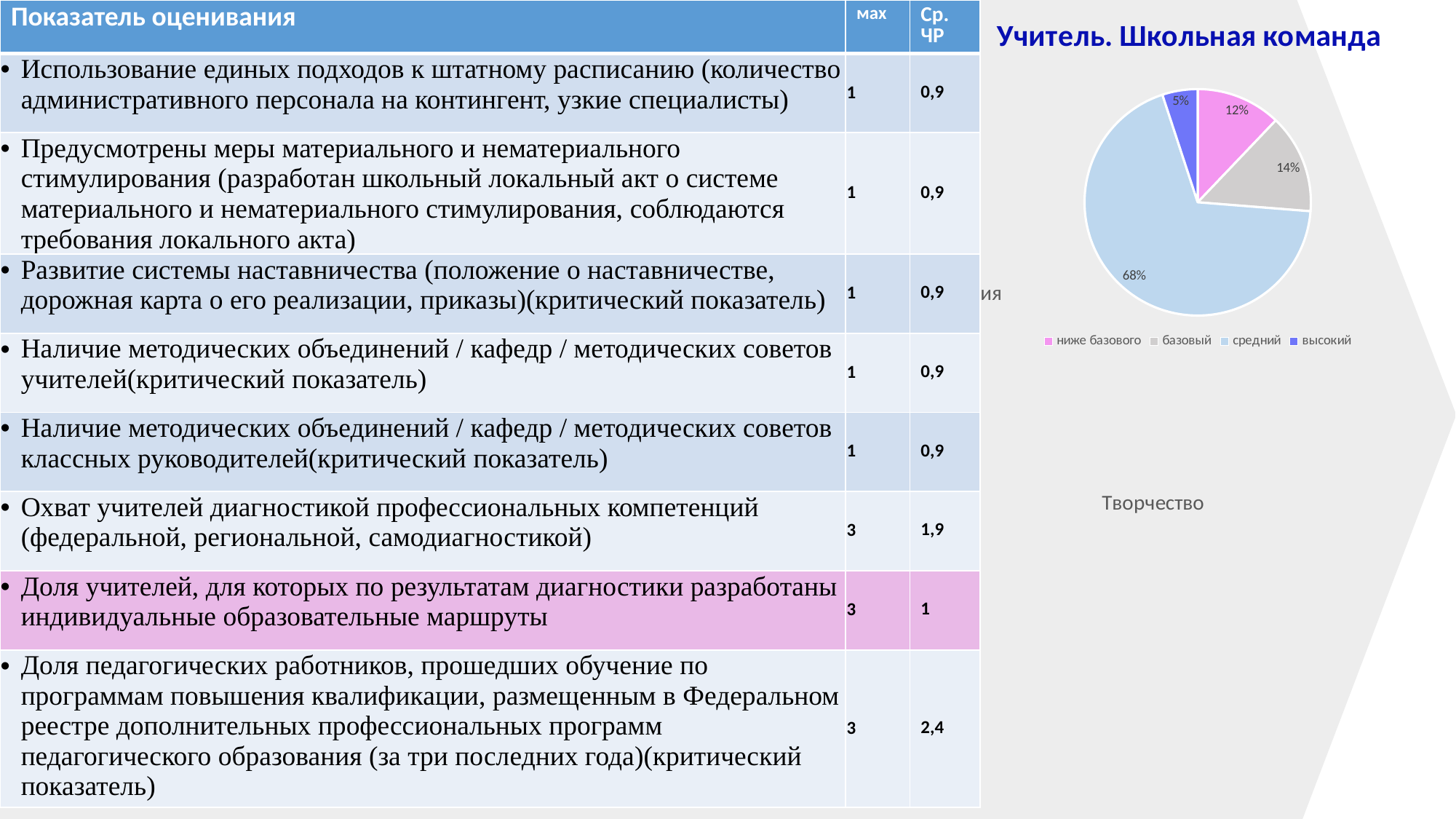
In the pie chart legend, which category is shown in pink? ниже базового How many categories does the pie chart legend list? 4 In the pie chart, what is the difference between the "средний" and "базовый" shares? 54% Which category has the smallest slice in the pie chart? высокий In the pie chart, what share does the "средний" slice have? 68% In the pie chart, what share does the "высокий" slice have? 5% What is the title shown above the pie chart? Учитель. Школьная команда In the pie chart, which slice is larger: "базовый" or "ниже базового"? базовый What type of chart is shown on the right side of the slide? pie chart In the pie chart, what share does the "ниже базового" slice have? 12% In the pie chart, what share does the "базовый" slice have? 14% Which category has the largest slice in the pie chart? средний